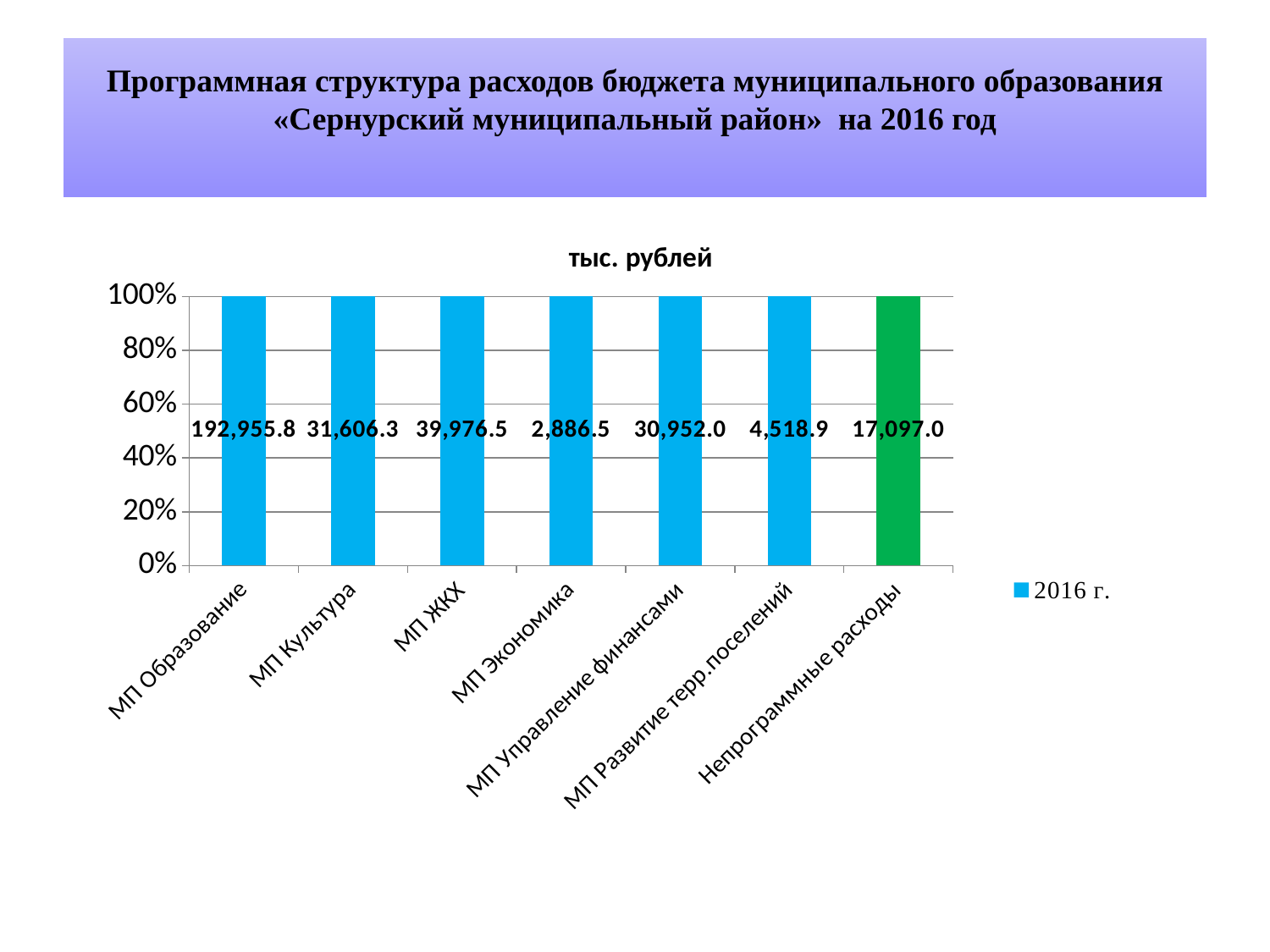
What is the data label value for Непрограммные расходы? 17,097.0 What is the data label value for МП Образование? 192,955.8 What kind of chart is shown on the slide? Bar chart Which has the larger labelled value, МП Культура or МП Управление финансами? МП Культура Which category has the highest labelled value? МП Образование How many series does the legend list? 1 What is the data label value for МП Управление финансами? 30,952.0 What is the difference between the labelled values for Непрограммные расходы and МП Развитие терр.поселений? 12,578.1 What is the difference between the labelled values for МП ЖКХ and МП Культура? 8,370.2 What is the data label value for МП Экономика? 2,886.5 How many categories are shown on the x axis? 7 Which category has the lowest labelled value? МП Экономика